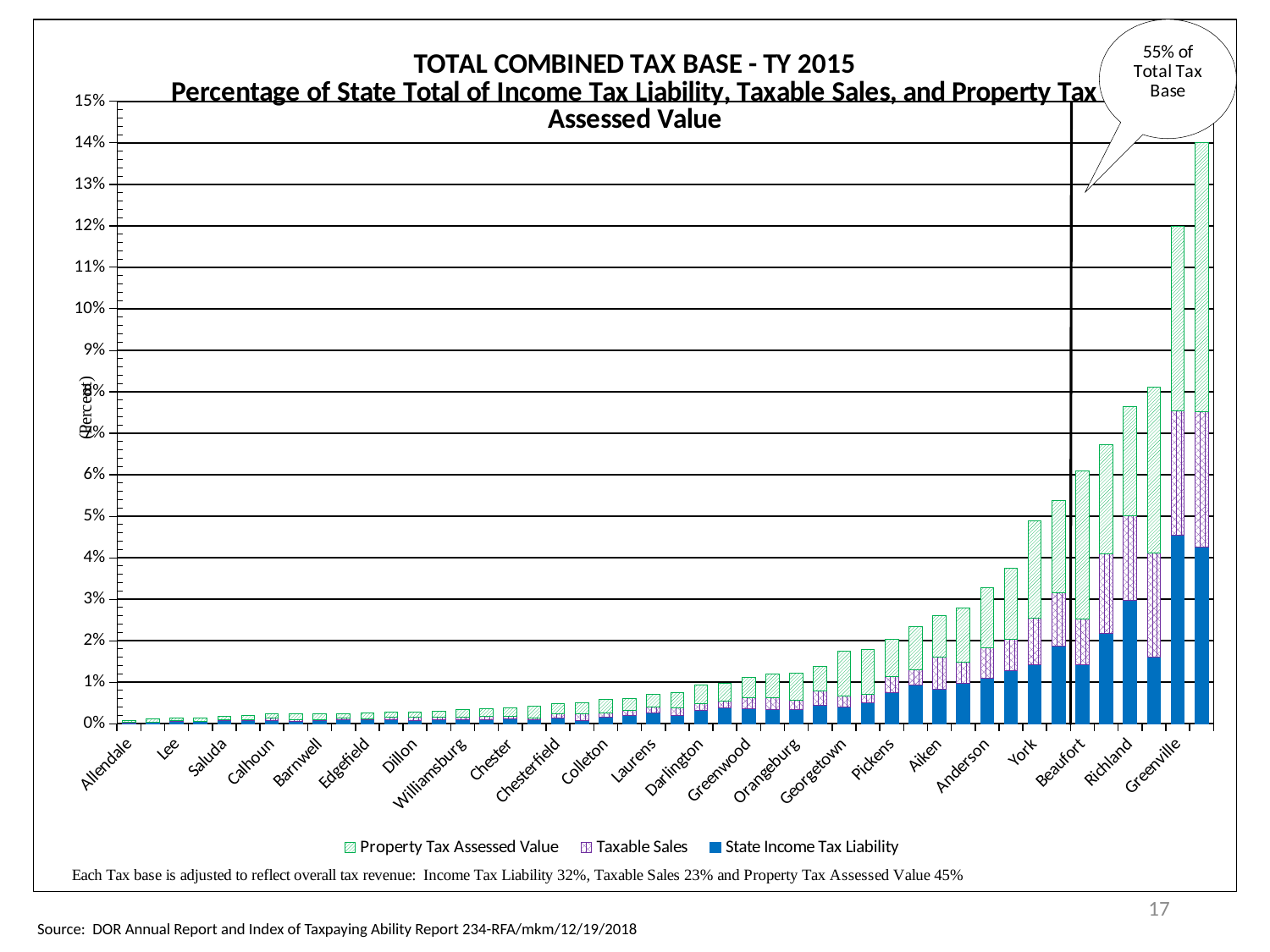
Is the total value for Richland greater or less than 7%? greater What kind of chart is shown on the slide? Stacked bar chart Is the total value for Allendale greater or less than 1%? less How many series does the legend list? 3 Is the total value for Greenville greater or less than 10%? greater Which has the larger total bar, Greenville or Richland? Greenville What does the callout at the top right of the chart say? 55% of Total Tax Base Do the total bar heights rise or fall moving from left to right along the x axis? Rise Which series is shown in solid blue at the bottom of each bar? State Income Tax Liability Which has the larger total bar, Beaufort or York? Beaufort